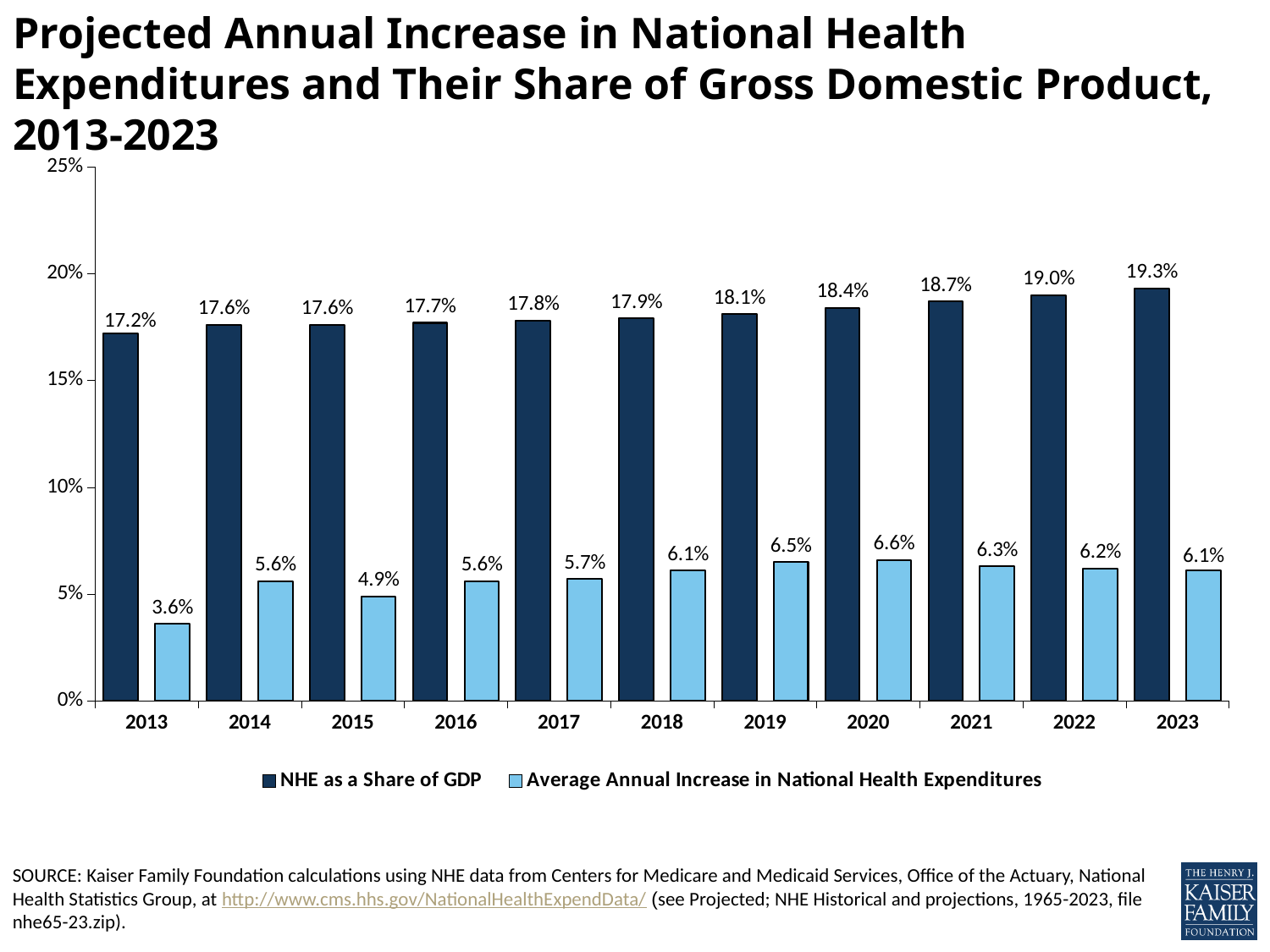
What is the value of NHE as a Share of GDP in 2013? 17.2% How many series does the legend list? 2 Does NHE as a Share of GDP rise or fall from 2013 to 2023? Rise What is the difference between NHE as a Share of GDP in 2023 and in 2013? 2.1% In which year is the Average Annual Increase in National Health Expenditures lowest? 2013 Which is larger: the Average Annual Increase in National Health Expenditures in 2015 or in 2016? 2016 How many years are shown on the x axis? 11 What is the value of NHE as a Share of GDP in 2023? 19.3% What kind of chart is shown on the slide? Bar chart What is the Average Annual Increase in National Health Expenditures in 2020? 6.6% Is the value of NHE as a Share of GDP in 2019 greater or less than 15%? greater In which year is NHE as a Share of GDP highest? 2023